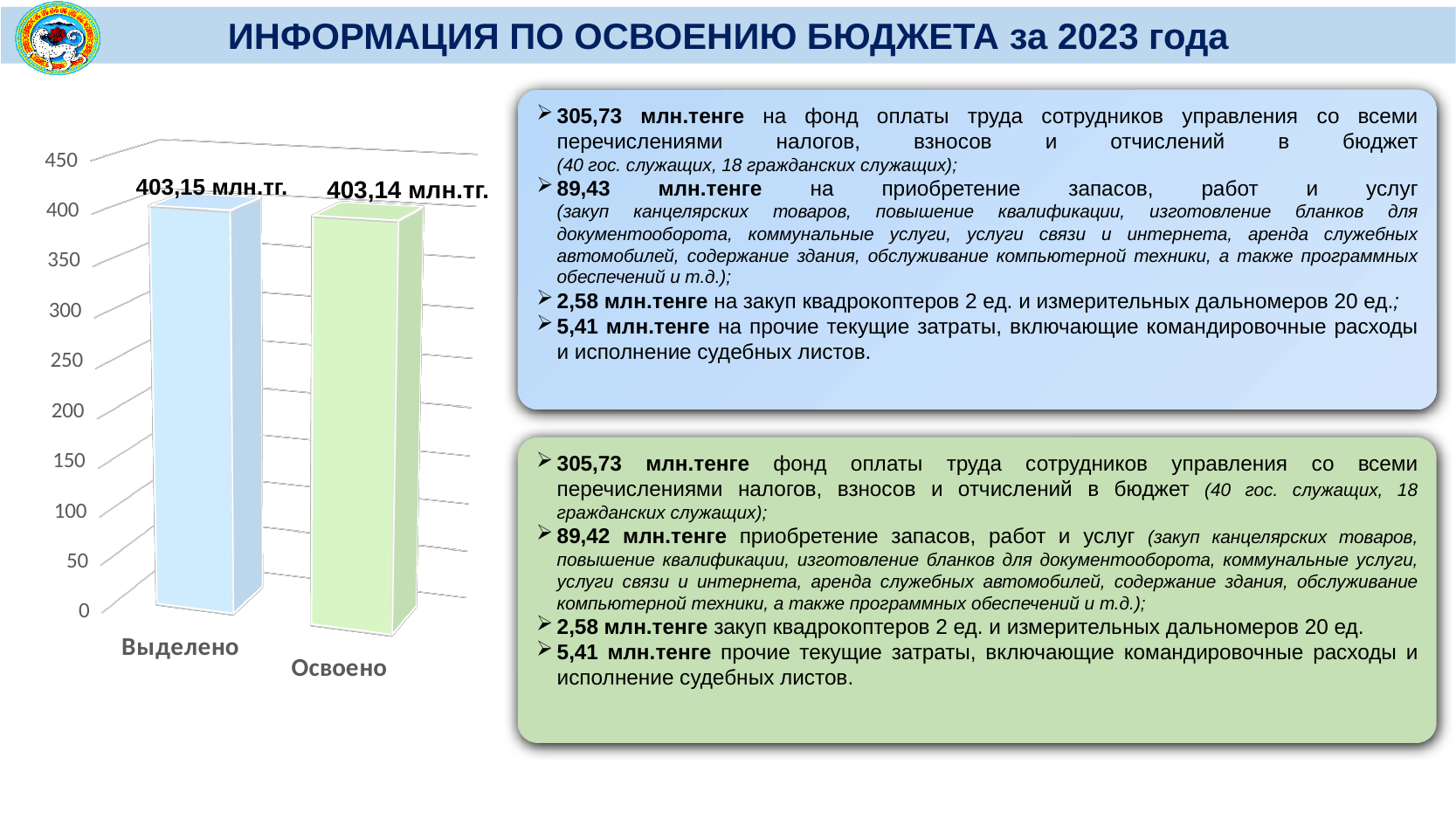
What are the two category labels on the chart's horizontal axis? Выделено, Освоено Is the value for 'Освоено' greater or less than 350? greater What value is shown for the 'Выделено' bar? 403,15 млн.тг. How many bars (categories) are plotted in the chart? 2 What is the highest value shown on the chart's vertical axis? 450 Is the value for 'Выделено' greater or less than 300? greater What kind of chart is shown on the slide? Bar chart What is the difference between the 'Выделено' and 'Освоено' values? 0,01 млн.тг. What value is shown for the 'Освоено' bar? 403,14 млн.тг.